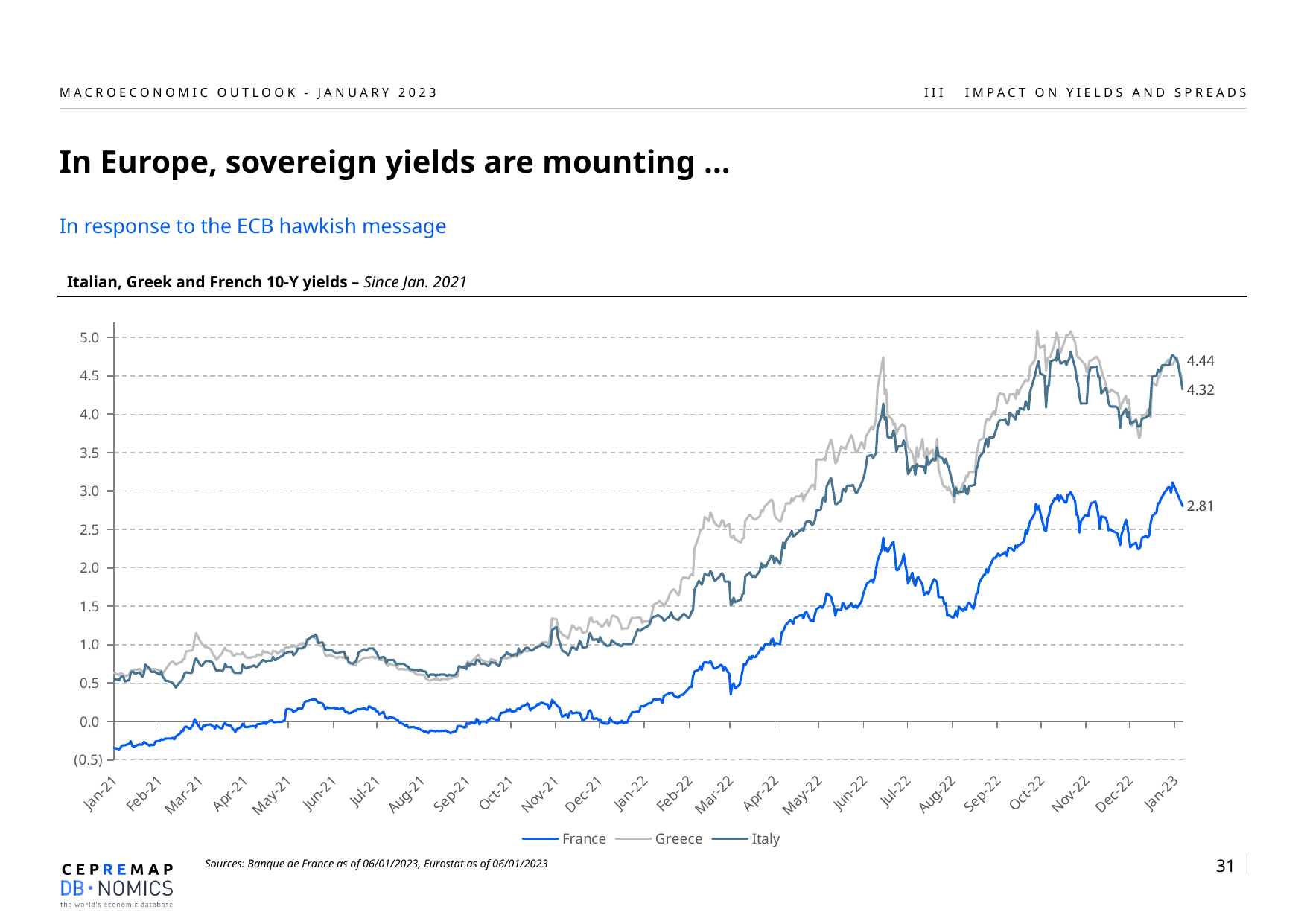
How many series does the legend list? 3 What is the highest value labelled at the right end of the chart? 4.44 Which series has the lowest yield at the end of the chart (Jan-23)? France Which series are listed in the legend? France, Greece, Italy Is the value for France in Jan-22 greater or less than 0.5? less Does the France yield rise or fall overall from Jan-21 to Jan-23? rise Is the value for France in Jan-21 greater or less than 0.0? less What is the title of the chart? Italian, Greek and French 10-Y yields – Since Jan. 2021 What is the lowest value labelled at the right end of the chart? 2.81 Is the value for Italy in Jan-21 greater or less than 1.0? less What is the latest value labelled for France at the right end of the chart? 2.81 What kind of chart is shown on the slide? line chart